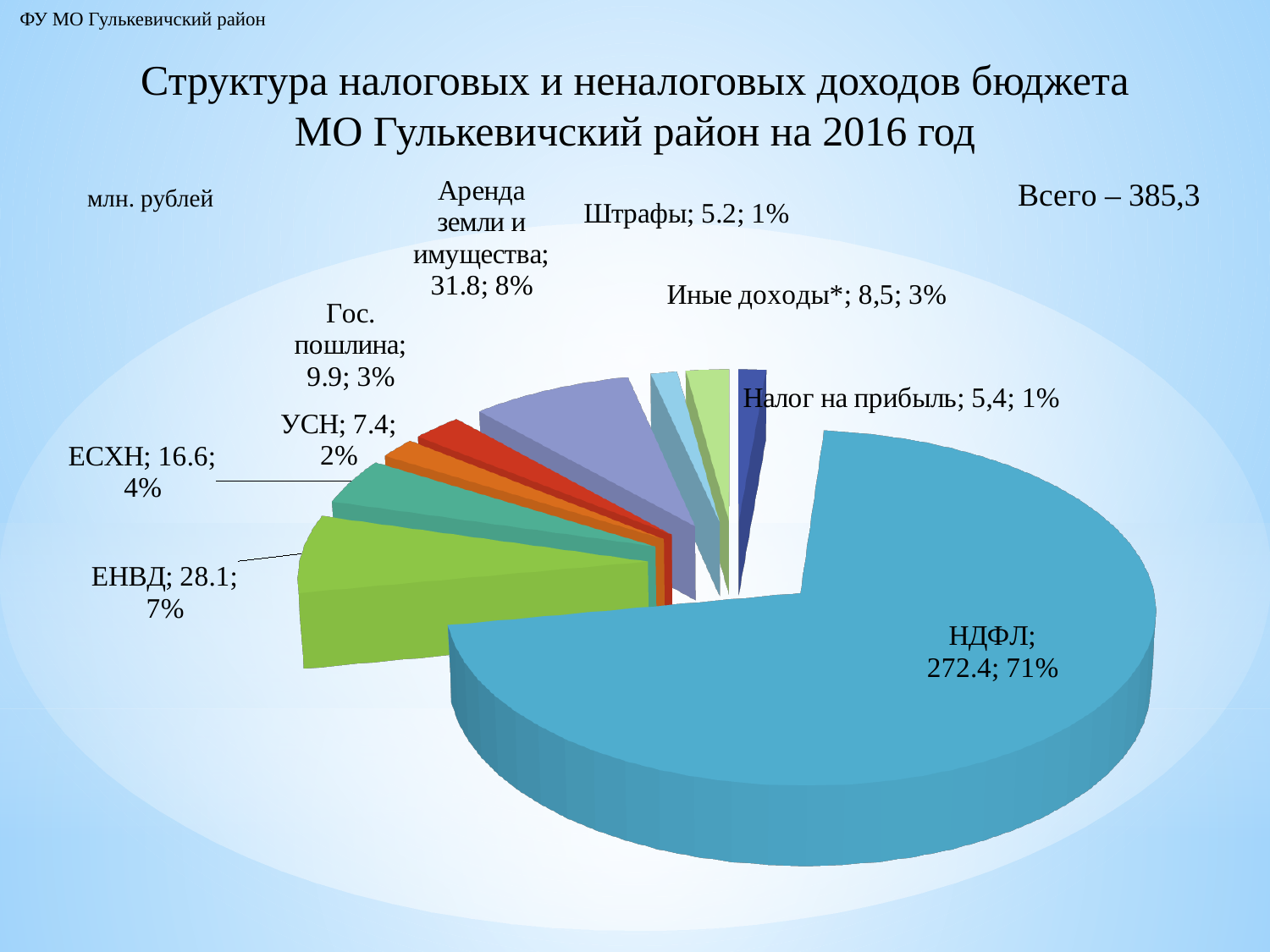
Which category has the largest slice of the pie? НДФЛ How many categories are shown in the pie chart? 9 What share of the pie does ЕНВД represent? 7% What is the value for Гос. пошлина? 9.9 What is the difference between the values for ЕНВД and ЕСХН? 11.5 What is the value for Аренда земли и имущества? 31.8 What is the value for НДФЛ? 272.4 What share of the pie does НДФЛ represent? 71% What total (Всего) is stated on the slide? 385,3 Which category has the smallest value? Штрафы Which is larger, the value for УСН or the value for Гос. пошлина? Гос. пошлина What type of chart is shown on the slide? pie chart